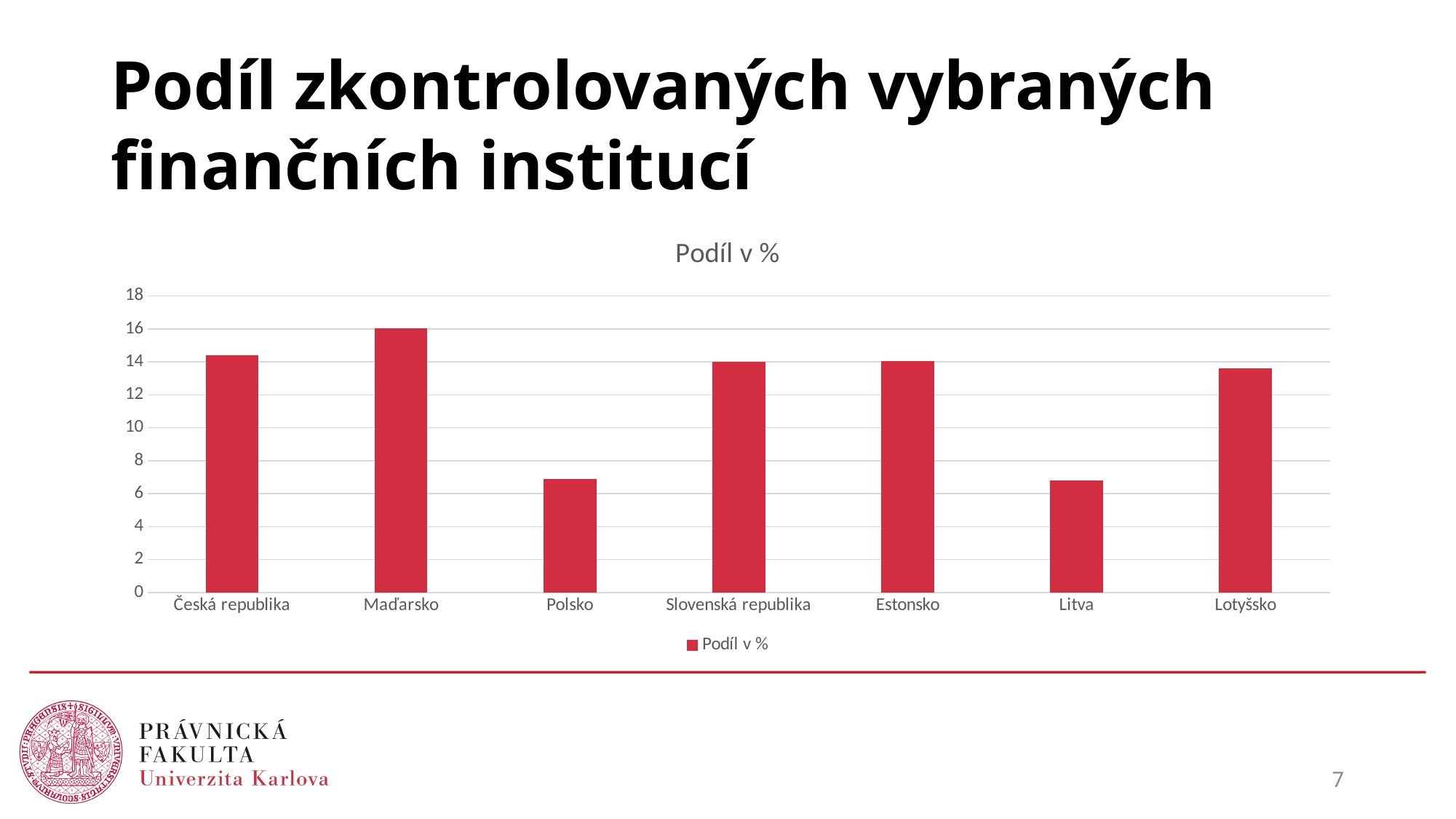
How many countries are shown on the x axis of the chart? 7 Is the value for Česká republika greater or less than 12? greater Which country has the highest value in the chart? Maďarsko What kind of chart is shown on the slide? bar chart What is the title of the chart? Podíl v % Which is larger, the value for Maďarsko or the value for Česká republika? Maďarsko How many series does the chart legend list? 1 Is the value for Lotyšsko greater or less than 12? greater Is the value for Litva greater or less than 8? less Which is larger, the value for Polsko or the value for Slovenská republika? Slovenská republika